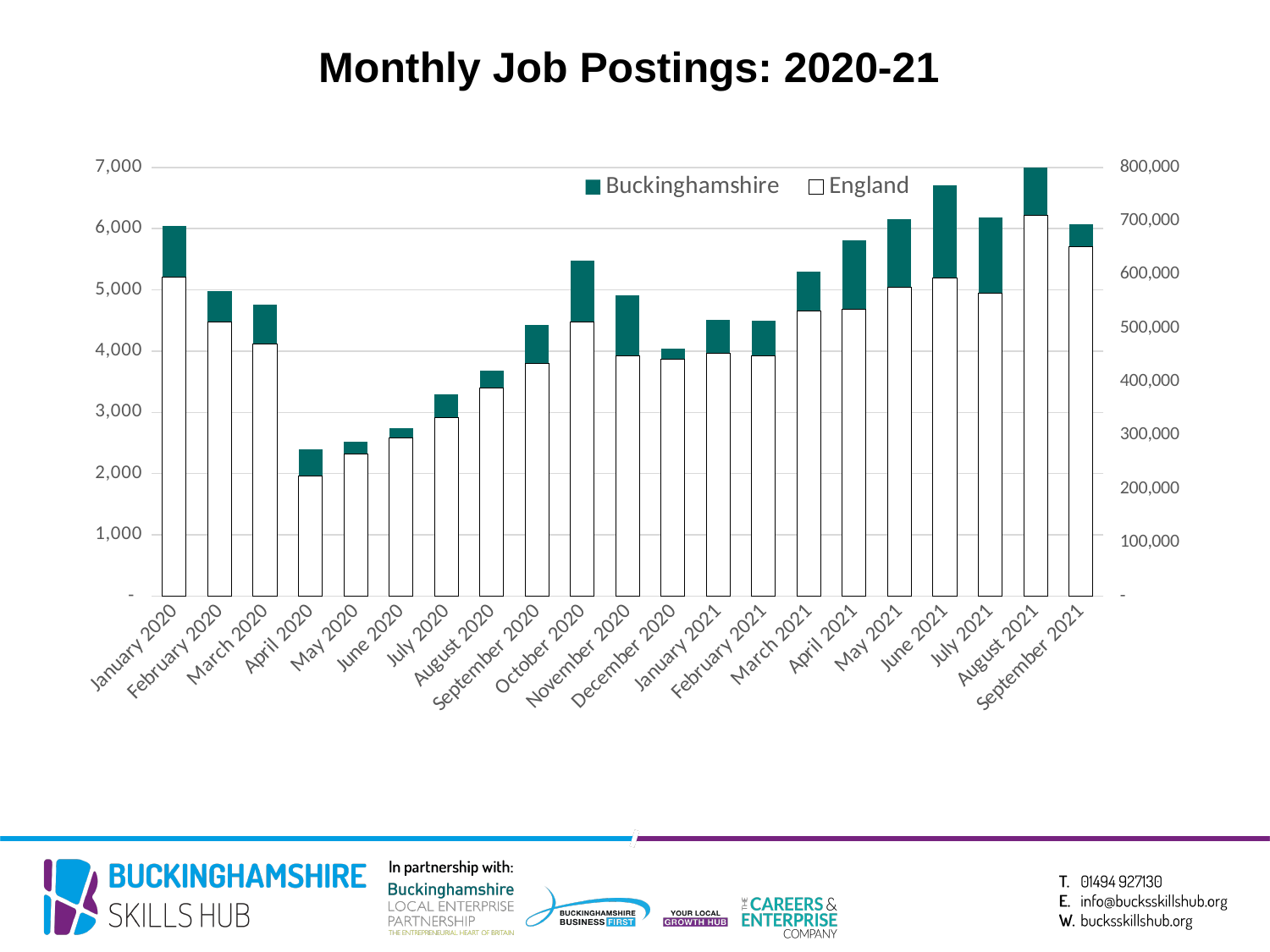
Do the bars generally rise or fall from April 2020 to October 2020? rise Which month has the tallest bar? August 2021 On the left axis, is the total bar for August 2021 greater or less than 6,000? greater Which month has the shortest bar? April 2020 Which series is shown in teal in the legend? Buckinghamshire Which bar is taller, October 2020 or September 2020? October 2020 What type of chart is shown on the slide? bar chart How many series does the legend list? 2 On the left axis, is the total bar for April 2020 greater or less than 3,000? less Which bar is taller, April 2020 or August 2021? August 2021 What is the title of the chart? Monthly Job Postings: 2020-21 How many months are plotted along the x axis? 21